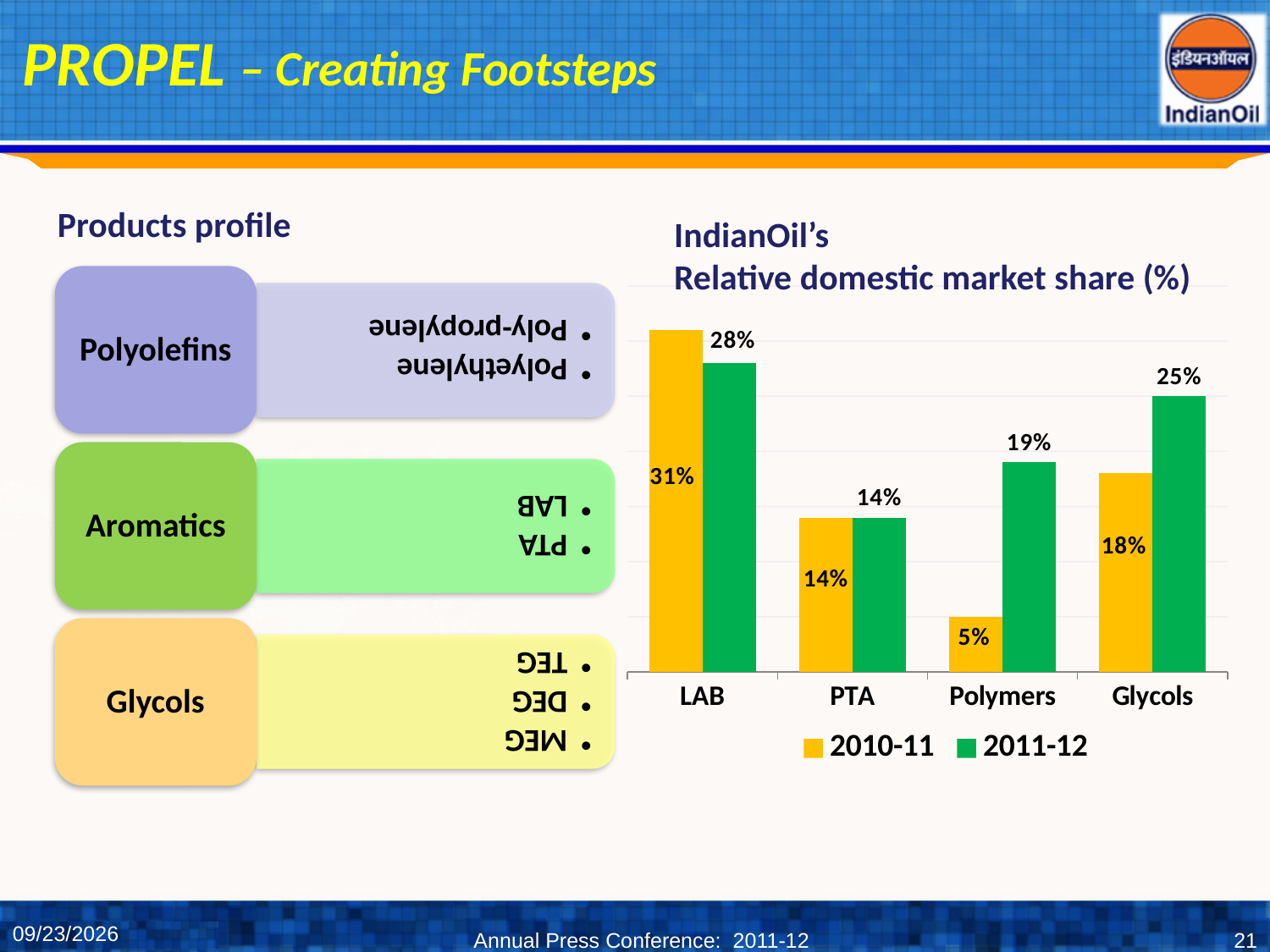
What is the difference between the 2011-12 and 2010-11 market share for Polymers? 14% Is the Glycols market share larger in 2010-11 or 2011-12? 2011-12 What is the 2011-12 market share value for Glycols? 25% What type of chart is used to show the relative domestic market share? Bar chart What is IndianOil's relative domestic market share for Polymers in 2011-12? 19% How many product categories are shown on the x axis of the chart? 4 Which category has the lowest market share in 2011-12? PTA How many series does the chart legend list? 2 Which category has the lowest market share in 2010-11? Polymers What is the 2010-11 market share value for PTA? 14% What is IndianOil's relative domestic market share for LAB in 2010-11? 31% Which category has the highest market share in 2010-11? LAB